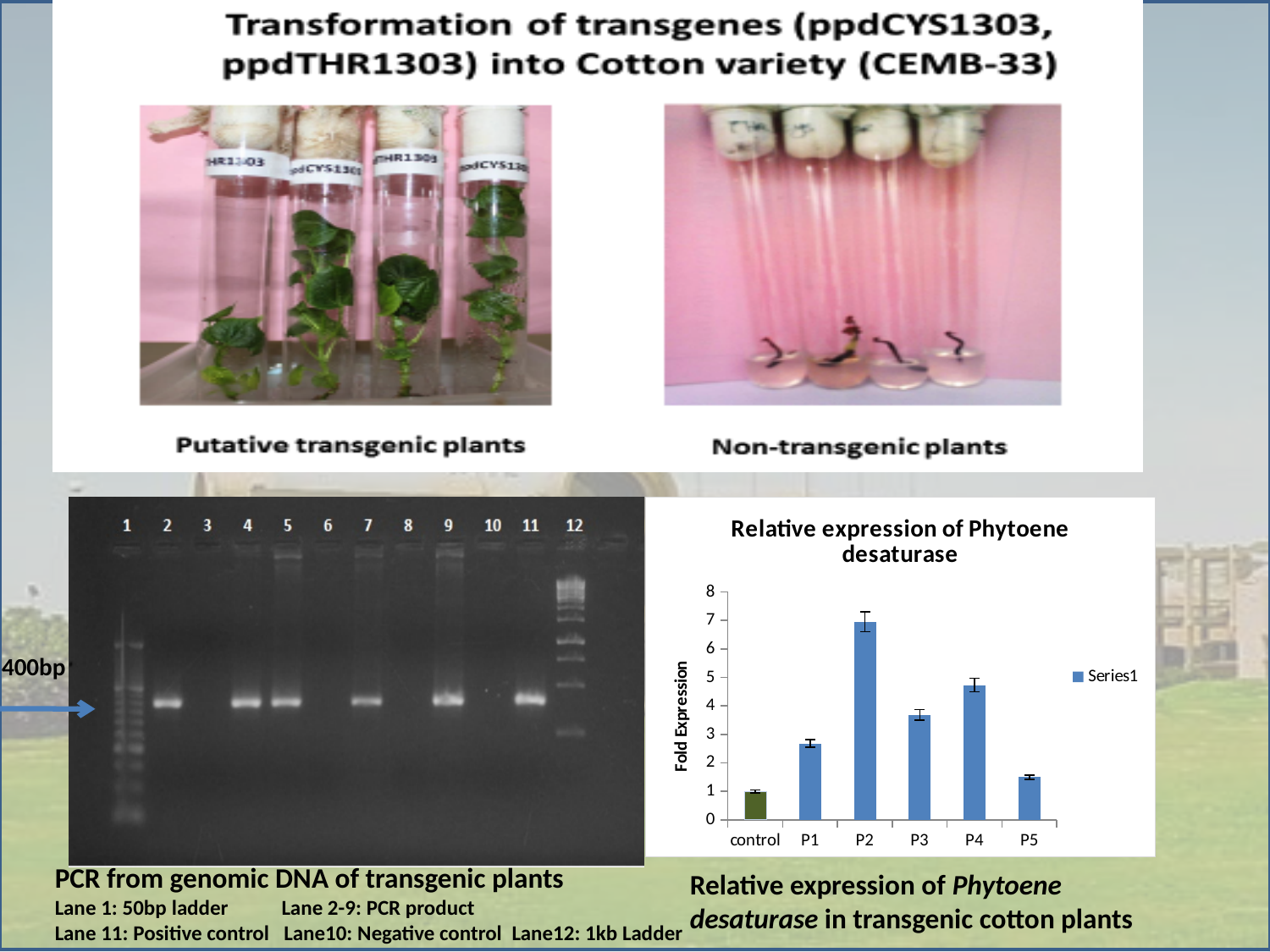
Which has a higher fold expression, P4 or P3? P4 Which has a higher fold expression, P1 or P5? P1 How many categories are plotted on the x axis of the Relative expression of Phytoene desaturase chart? 6 Is the fold expression for P5 greater or less than 2? less Which category has the highest fold expression in the chart? P2 What is the legend entry shown in the chart? Series1 How many series does the legend of the chart list? 1 What kind of chart is shown on the slide? bar chart Which category has the lowest fold expression in the chart? control Is the fold expression for P2 greater or less than 6? greater Is the fold expression for P4 greater or less than 4? greater What is the label of the y axis of the chart? Fold Expression